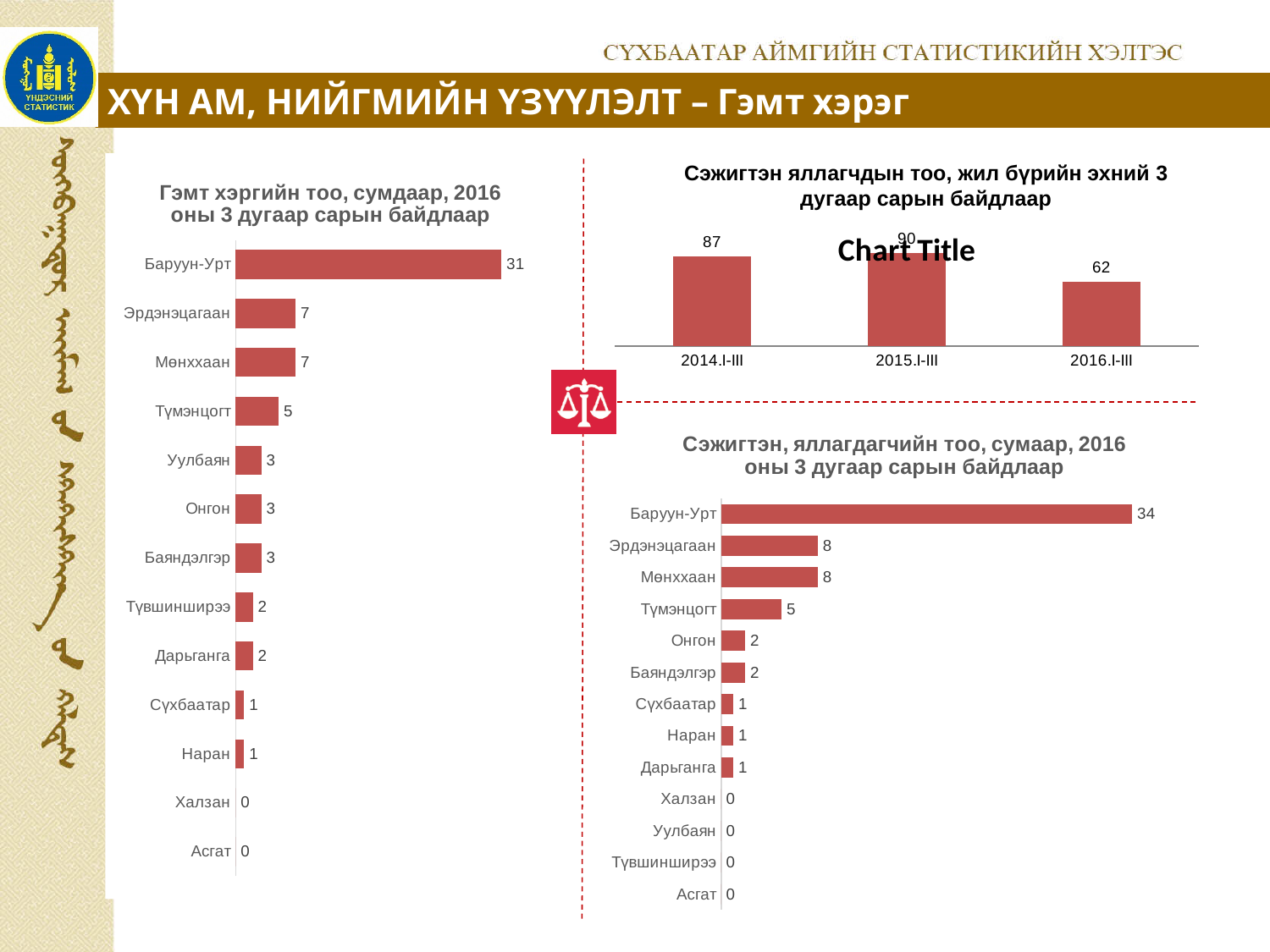
What kind of chart is the top-right chart 'Сэжигтэн яллагчдын тоо'? Bar chart In the bottom-right chart 'Сэжигтэн, яллагдагчийн тоо, сумаар, 2016 оны 3 дугаар сарын байдлаар', what is the value for Баруун-Урт? 34 In the bottom-right chart 'Сэжигтэн, яллагдагчийн тоо, сумаар', which is larger, Түмэнцогт or Онгон? Түмэнцогт In the top-right chart 'Сэжигтэн яллагчдын тоо', what is the difference between 2015.I-III and 2016.I-III? 28 In the bottom-right chart 'Сэжигтэн, яллагдагчийн тоо, сумаар', what is the value for Мөнххаан? 8 In the left chart 'Гэмт хэргийн тоо, сумдаар', what is the value for Түмэнцогт? 5 In the left chart 'Гэмт хэргийн тоо, сумдаар', which category has the highest value? Баруун-Урт In the left chart 'Гэмт хэргийн тоо, сумдаар, 2016 оны 3 дугаар сарын байдлаар', what is the value for Баруун-Урт? 31 In the left chart 'Гэмт хэргийн тоо, сумдаар', what is the difference between Баруун-Урт and Эрдэнэцагаан? 24 How many categories are shown in the left chart 'Гэмт хэргийн тоо, сумдаар'? 13 In the top-right chart 'Сэжигтэн яллагчдын тоо', which period has the lowest value? 2016.I-III In the top-right chart 'Сэжигтэн яллагчдын тоо, жил бүрийн эхний 3 дугаар сарын байдлаар', what is the value for 2015.I-III? 90